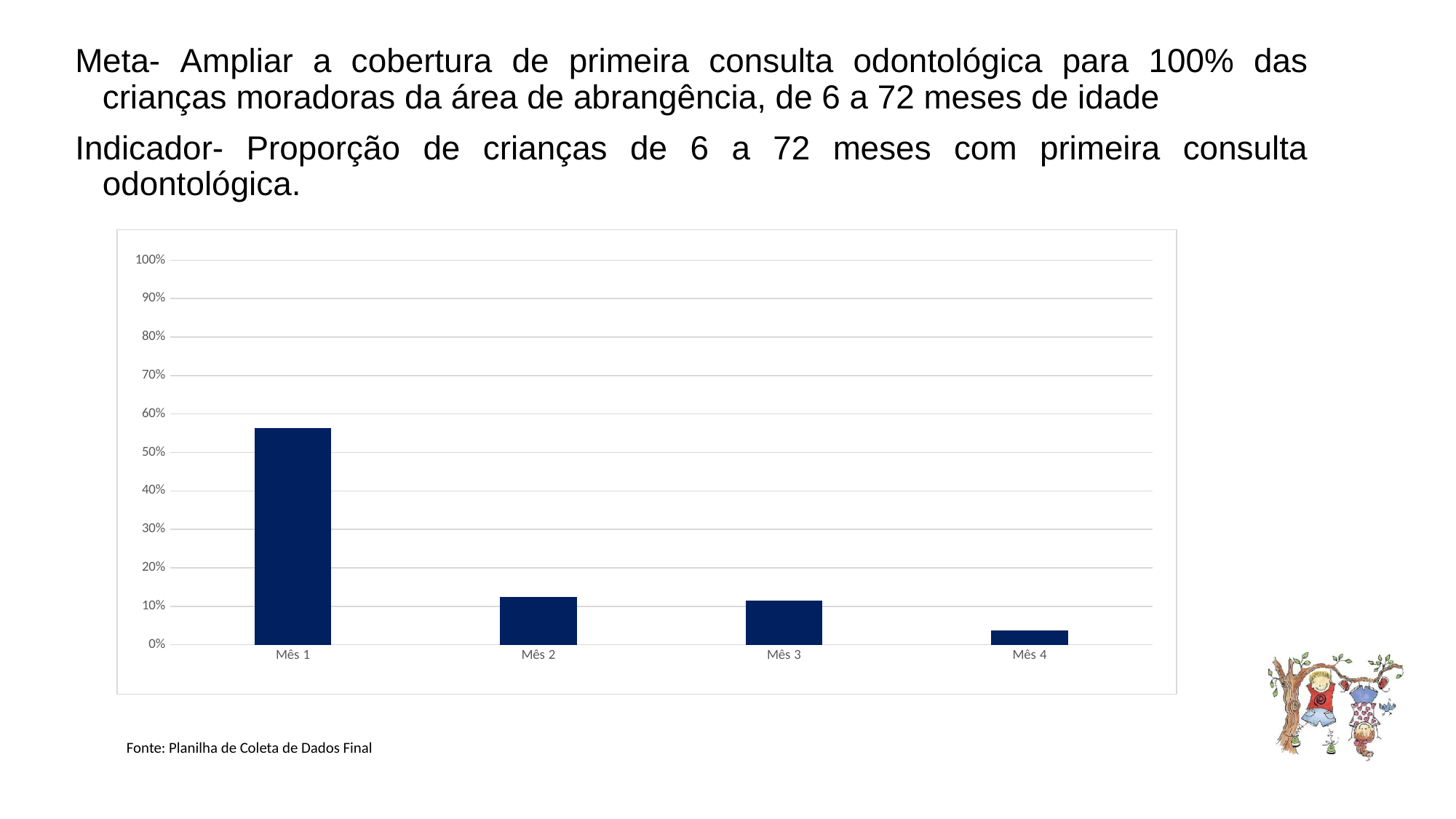
What kind of chart is shown on the slide? bar chart Is the value for Mês 1 greater or less than 60%? less Do the values generally rise or fall from Mês 1 to Mês 4? fall What source is cited below the chart? Planilha de Coleta de Dados Final Is the value for Mês 4 greater or less than 10%? less Is the value for Mês 2 greater or less than 10%? greater Which month has the highest value on the chart? Mês 1 Which is larger, the value for Mês 1 or the value for Mês 2? Mês 1 How many categories (months) are plotted on the chart? 4 Which month has the lowest value on the chart? Mês 4 Which is larger, the value for Mês 3 or the value for Mês 4? Mês 3